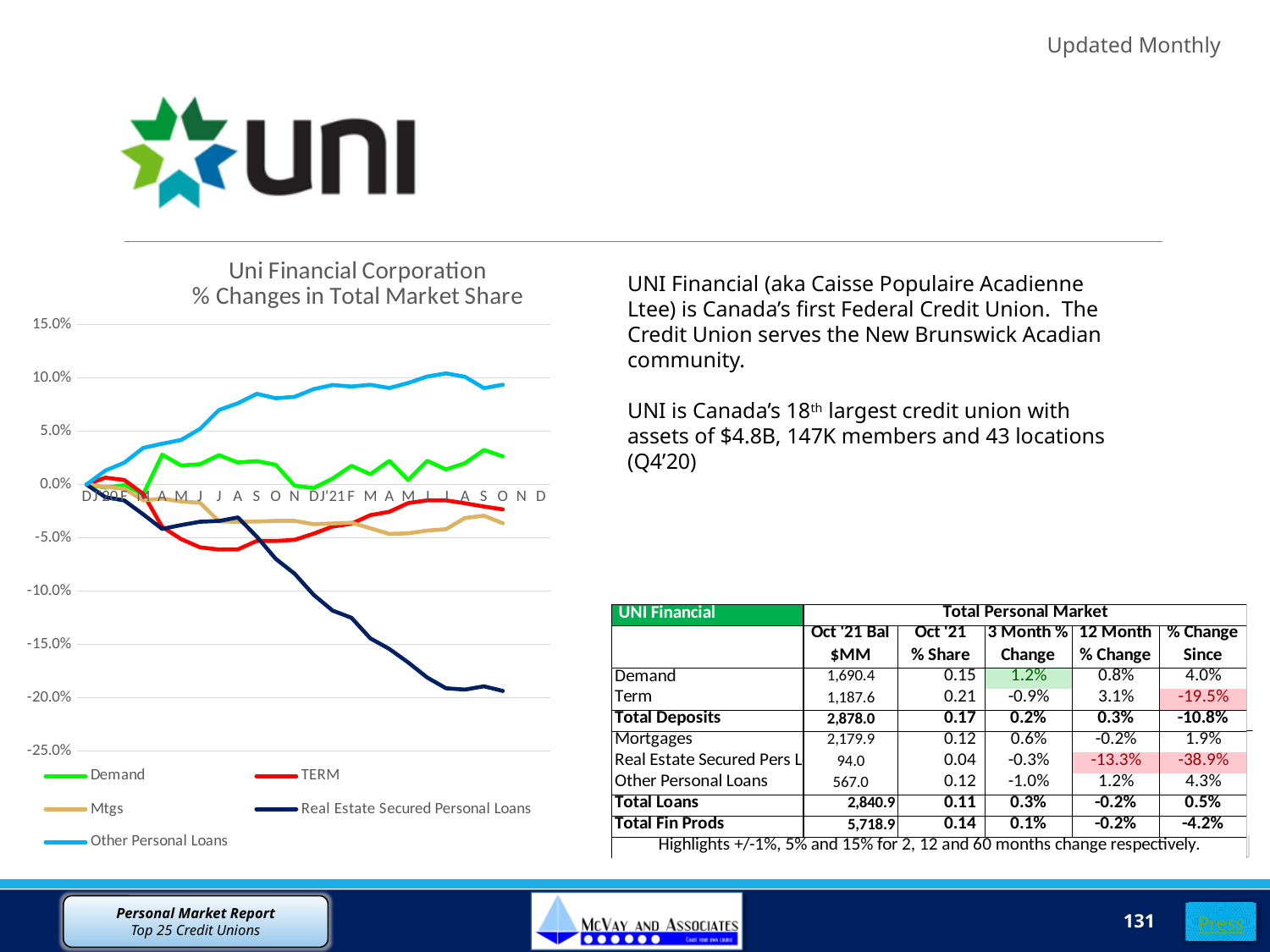
What kind of chart is shown on the slide? line chart Is the value for Other Personal Loans at the end of the chart greater or less than 5.0%? greater What is the title of the chart? Uni Financial Corporation % Changes in Total Market Share At the end of the chart, which is higher: Mtgs or Real Estate Secured Personal Loans? Mtgs Is the value for Real Estate Secured Personal Loans at the end of the chart greater or less than -15.0%? less Is the value for Mtgs at the end of the chart greater or less than 0.0%? less Which series is lowest at the end of the chart (D at the far right)? Real Estate Secured Personal Loans Which series is highest at the end of the chart (D at the far right)? Other Personal Loans How many series does the legend of the chart list? 5 Does the Real Estate Secured Personal Loans line rise or fall over the period shown? fall Does the Other Personal Loans line rise or fall over the period shown? rise